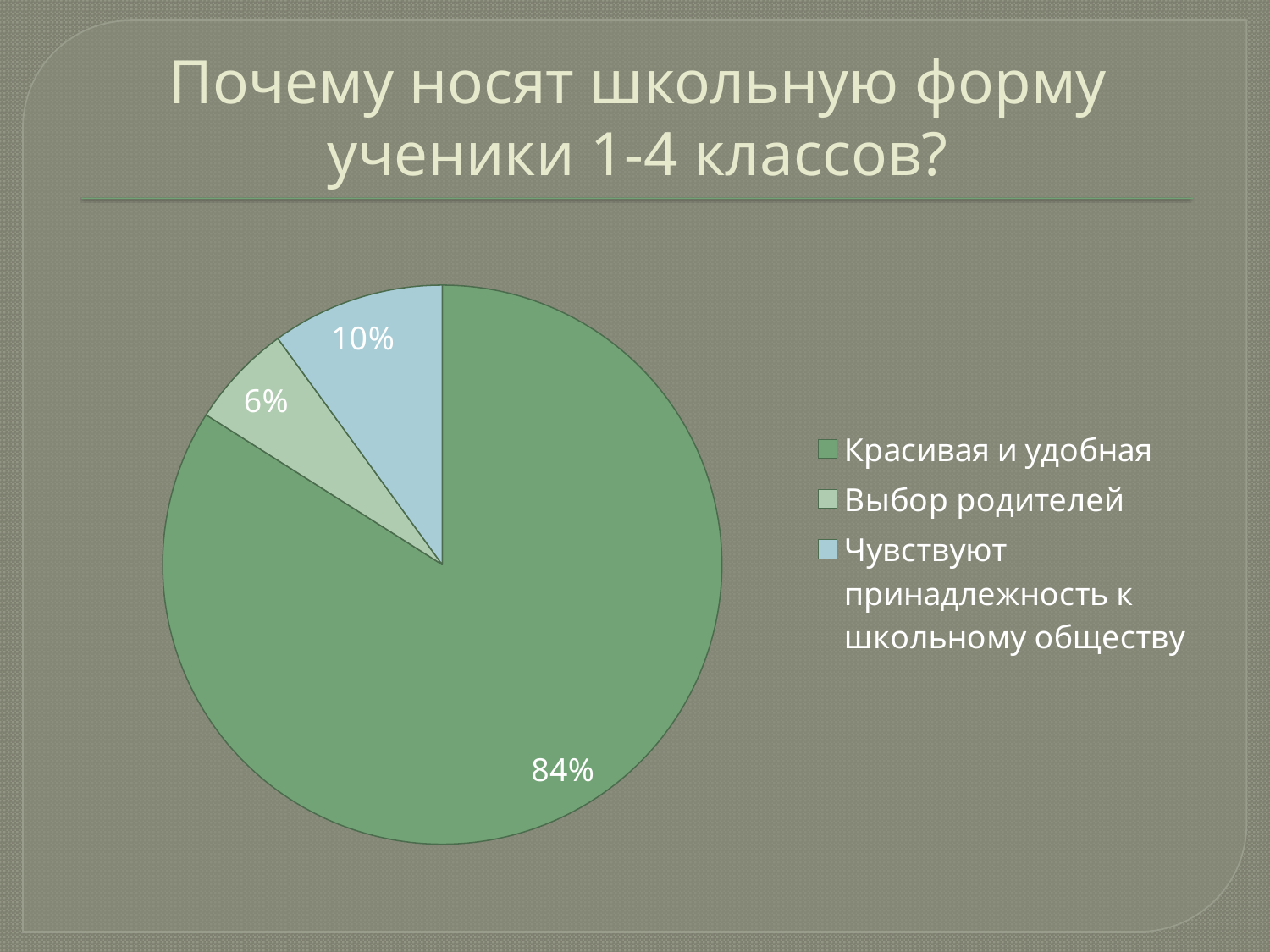
What is the difference in percentage points between "Красивая и удобная" and "Чувствуют принадлежность к школьному обществу"? 74 What is the title of the chart slide? Почему носят школьную форму ученики 1-4 классов? What kind of chart is shown on the slide? pie chart What share of the pie is labelled "Чувствуют принадлежность к школьному обществу"? 10% What share of the pie is labelled "Красивая и удобная"? 84% What colour is the slice for "Чувствуют принадлежность к школьному обществу"? light blue Which is larger: the slice for "Выбор родителей" or the slice for "Чувствуют принадлежность к школьному обществу"? Чувствуют принадлежность к школьному обществу What share of the pie is labelled "Выбор родителей"? 6% How many entries does the legend list? 3 How many categories does the pie chart show? 3 Which category has the largest slice of the pie? Красивая и удобная Which category has the smallest slice of the pie? Выбор родителей